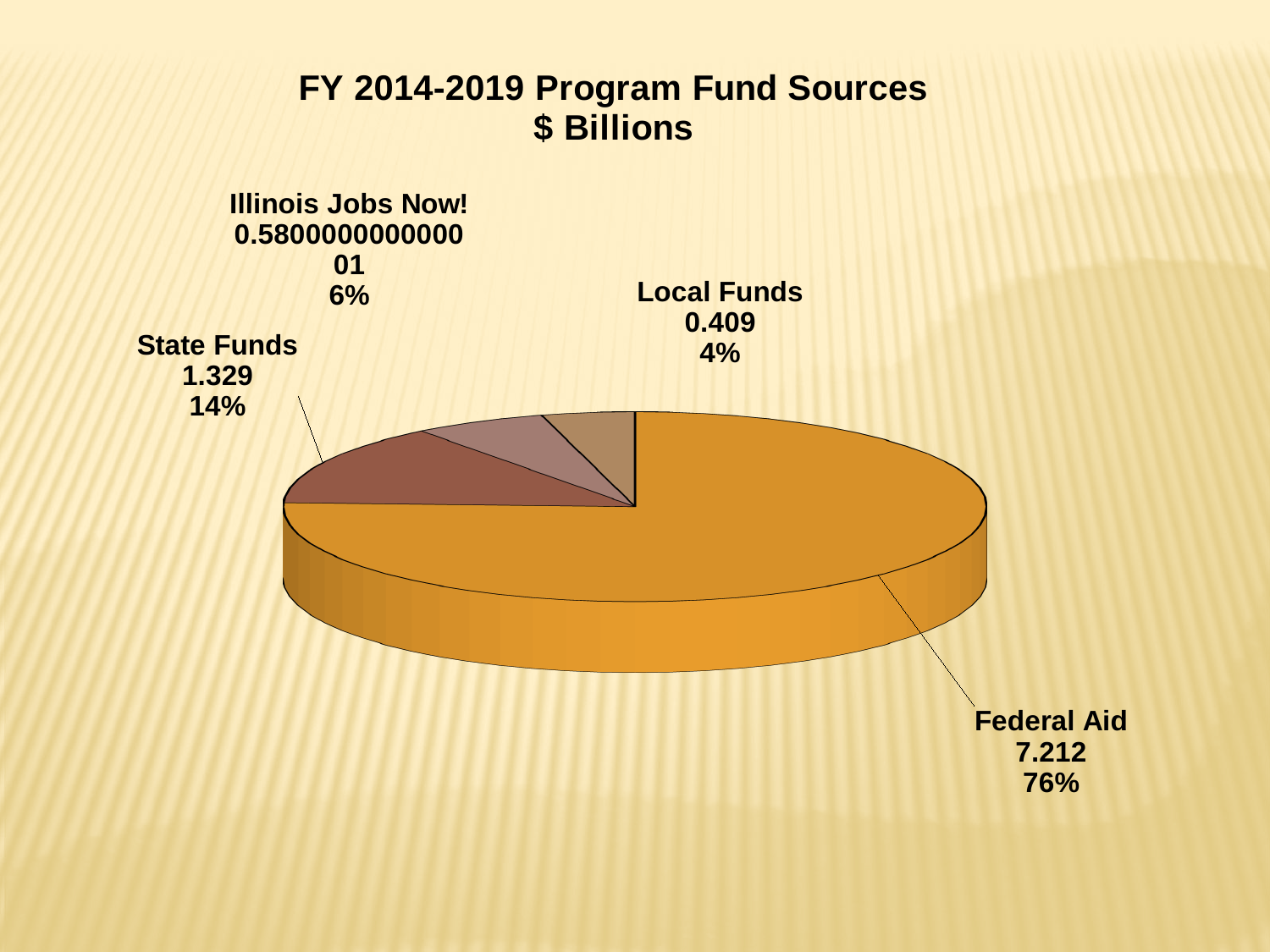
What kind of chart is shown on the slide? pie chart What is the value for State Funds? 1.329 What share of the pie does State Funds represent? 14% What is the title of the chart? FY 2014-2019 Program Fund Sources $ Billions What is the value for Federal Aid? 7.212 What is the difference between the Federal Aid value and the State Funds value? 5.883 Which fund source is the largest? Federal Aid Which fund source is the smallest? Local Funds What share of the pie does Federal Aid represent? 76% What share of the pie does Illinois Jobs Now! represent? 6% How many slices does the pie chart have? 4 What is the value for Local Funds? 0.409